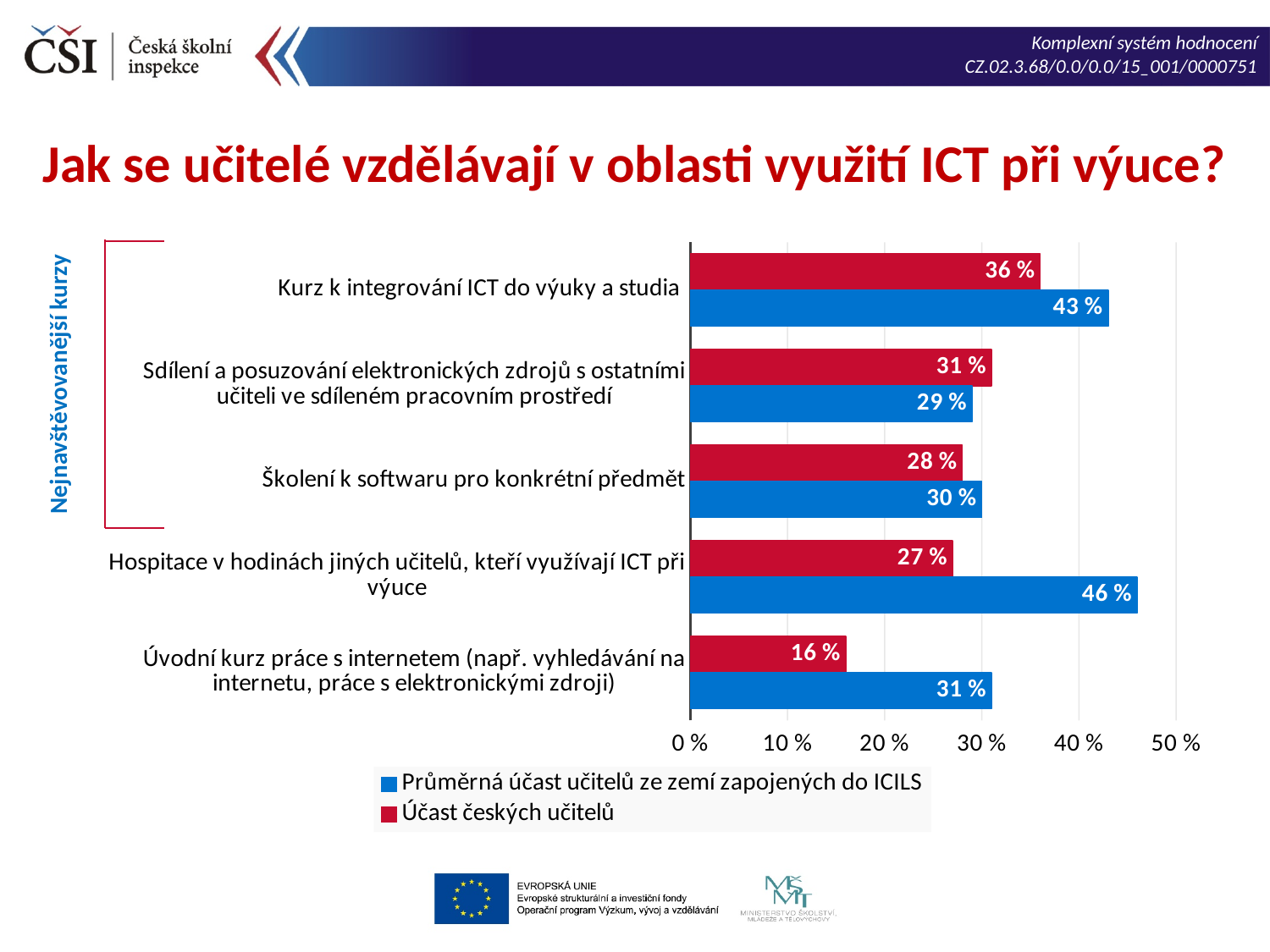
What kind of chart is shown on the slide? bar chart Which colour represents Účast českých učitelů in the chart? red Is the value for Účast českých učitelů for "Školení k softwaru pro konkrétní předmět" greater or less than 30 %? less What is the value for Průměrná účast učitelů ze zemí zapojených do ICILS for "Hospitace v hodinách jiných učitelů, kteří využívají ICT při výuce"? 46 % Which category has the highest value for Průměrná účast učitelů ze zemí zapojených do ICILS? Hospitace v hodinách jiných učitelů, kteří využívají ICT při výuce What is the value for Účast českých učitelů for "Úvodní kurz práce s internetem"? 16 % For "Sdílení a posuzování elektronických zdrojů s ostatními učiteli ve sdíleném pracovním prostředí", which is larger: Účast českých učitelů or Průměrná účast učitelů ze zemí zapojených do ICILS? Účast českých učitelů Which category has the lowest value for Účast českých učitelů? Úvodní kurz práce s internetem (např. vyhledávání na internetu, práce s elektronickými zdroji) How many categories (courses) are shown in the chart? 5 What is the difference between the ICILS average and Czech teachers' participation for "Hospitace v hodinách jiných učitelů, kteří využívají ICT při výuce"? 19 % What is the value for Účast českých učitelů for "Kurz k integrování ICT do výuky a studia"? 36 % How many series does the legend list? 2